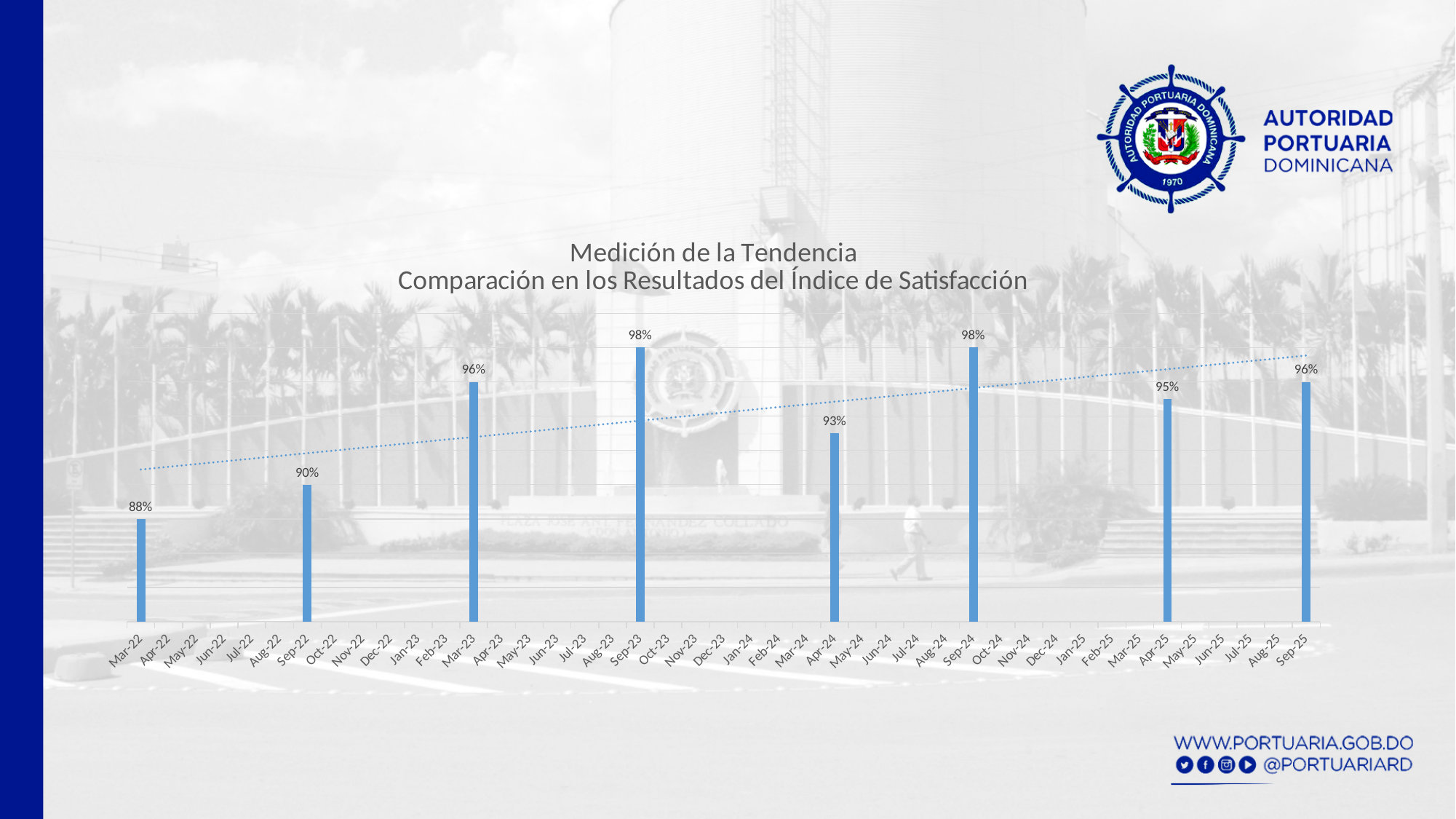
What kind of chart is shown on the slide? Bar chart Does the dotted trend line rise or fall from left to right? Rises What is the difference between the values for Mar-23 and Mar-22? 8% What is the satisfaction index value for Sep-25? 96% Which is larger, the value for Apr-25 or the value for Sep-22? Apr-25 What is the satisfaction index value for Mar-22? 88% How many bars with data values are plotted on the chart? 8 What is the satisfaction index value for Apr-24? 93% What is the highest satisfaction index value shown on the chart? 98% Which period has the lowest satisfaction index value? Mar-22 What is the satisfaction index value for Sep-23? 98% What is the difference between the values for Sep-24 and Apr-24? 5%